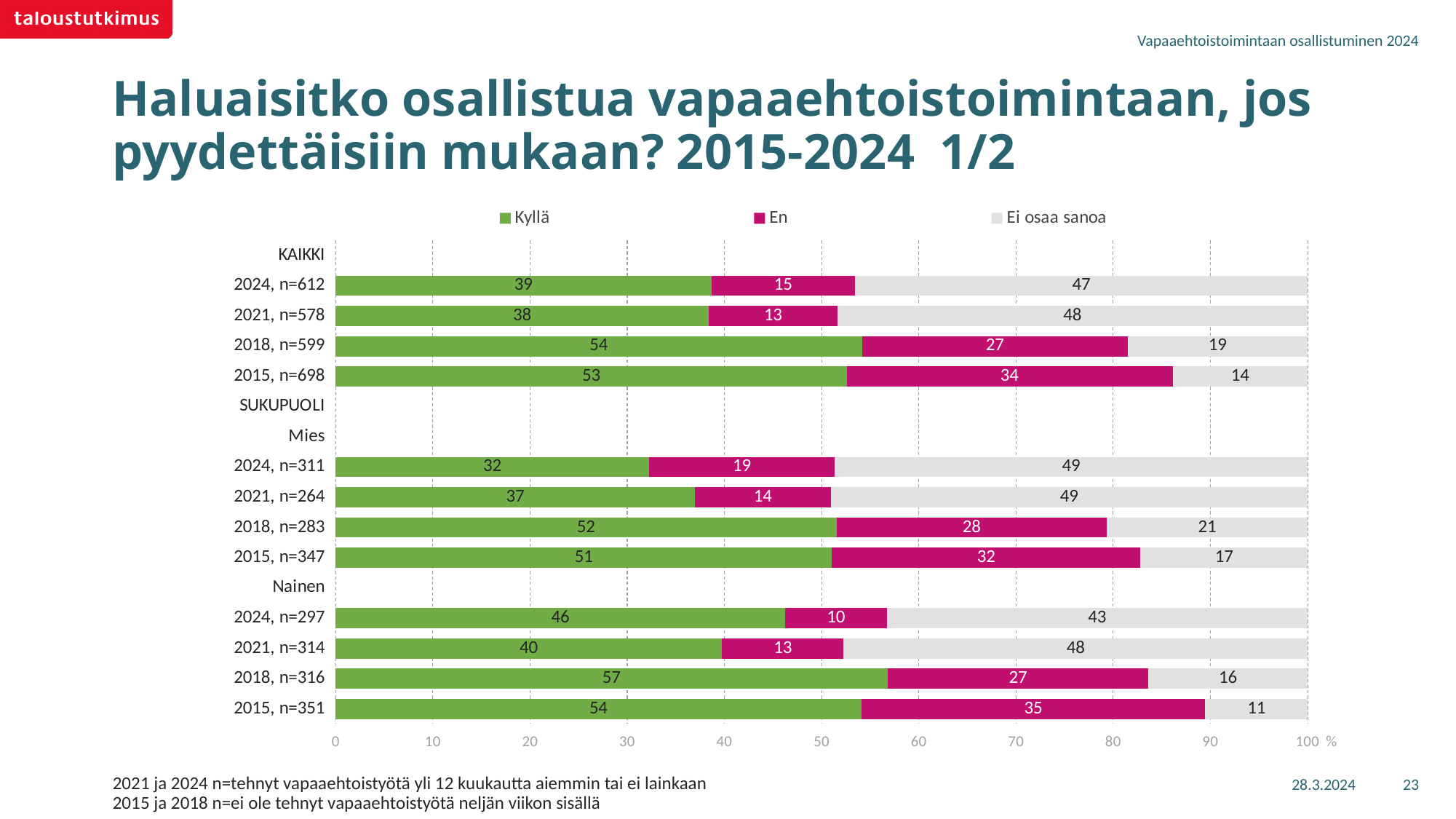
Which legend entry is shown in green? Kyllä Which bar has the highest Kyllä value? Nainen 2018, n=316 How many series does the legend list? 3 What is the En value for Mies 2024, n=311? 19 Which bar has the lowest En value? Nainen 2024, n=297 What is the Ei osaa sanoa value for Nainen 2015, n=351? 11 What is the difference between the Kyllä values for Nainen 2024, n=297 and Mies 2024, n=311? 14 What is the Kyllä value for KAIKKI 2024, n=612? 39 How many data bars are plotted in the chart? 12 Which is larger, the En value for KAIKKI 2015, n=698 or the En value for KAIKKI 2018, n=599? KAIKKI 2015, n=698 What kind of chart is shown on the slide? Stacked bar chart What is the total of the Kyllä and En values for Mies 2018, n=283? 80